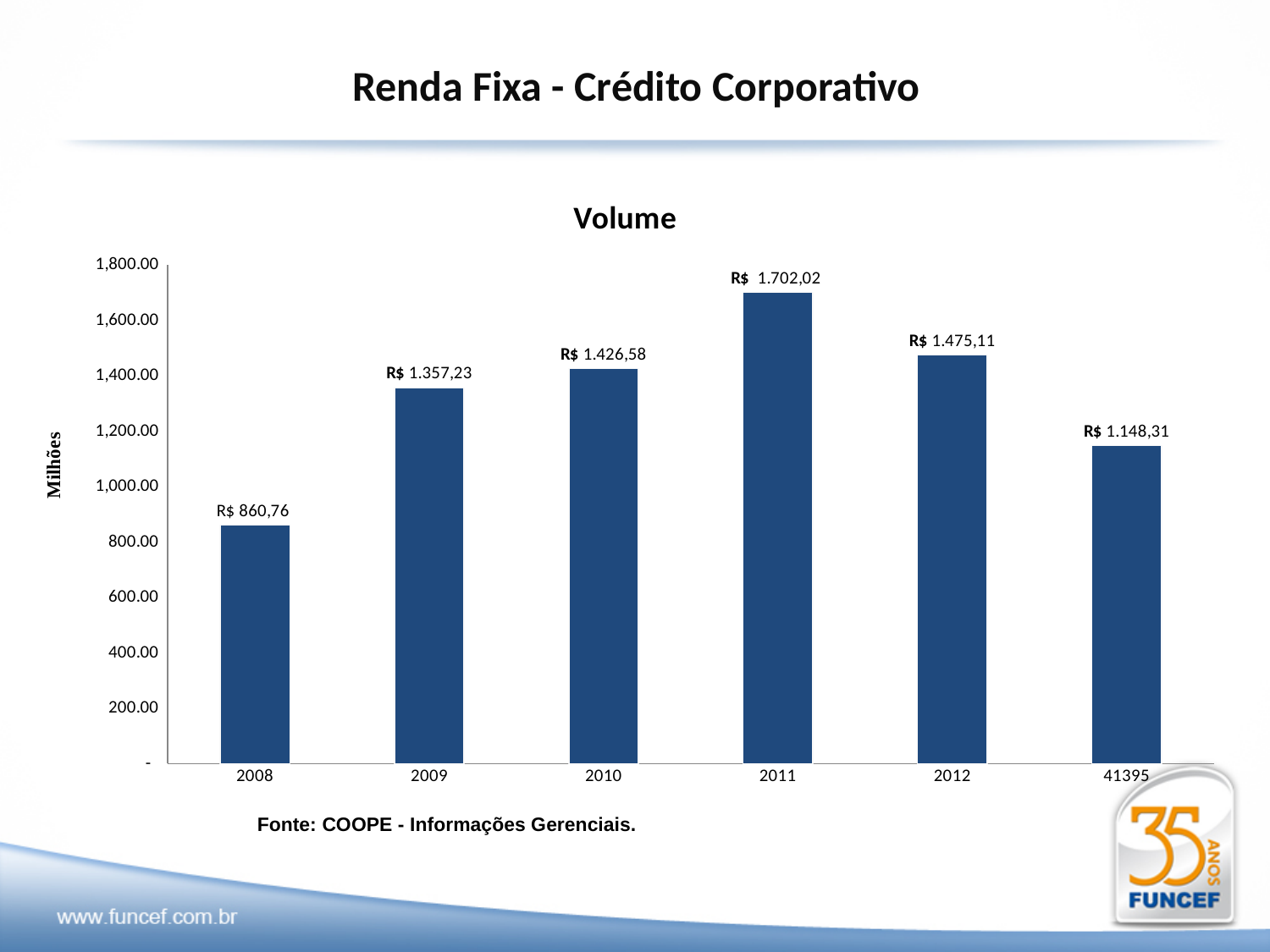
Which category has the lowest volume? 2008 What is the value for 2012 in the Volume chart? R$ 1.475,11 What is the label on the vertical axis of the chart? Milhões What is the value for the category labelled 41395 in the Volume chart? R$ 1.148,31 What is the difference between the 2011 and 2012 values? R$ 226,91 What is the value for 2011 in the Volume chart? R$ 1.702,02 Which is larger, the value for 2010 or the value for 2012? 2012 How many bars are shown in the Volume chart? 6 What kind of chart is shown on the slide? Bar chart What is the difference between the 2009 and 2008 values? R$ 496,47 What is the value for 2008 in the Volume chart? R$ 860,76 Which year has the highest volume? 2011